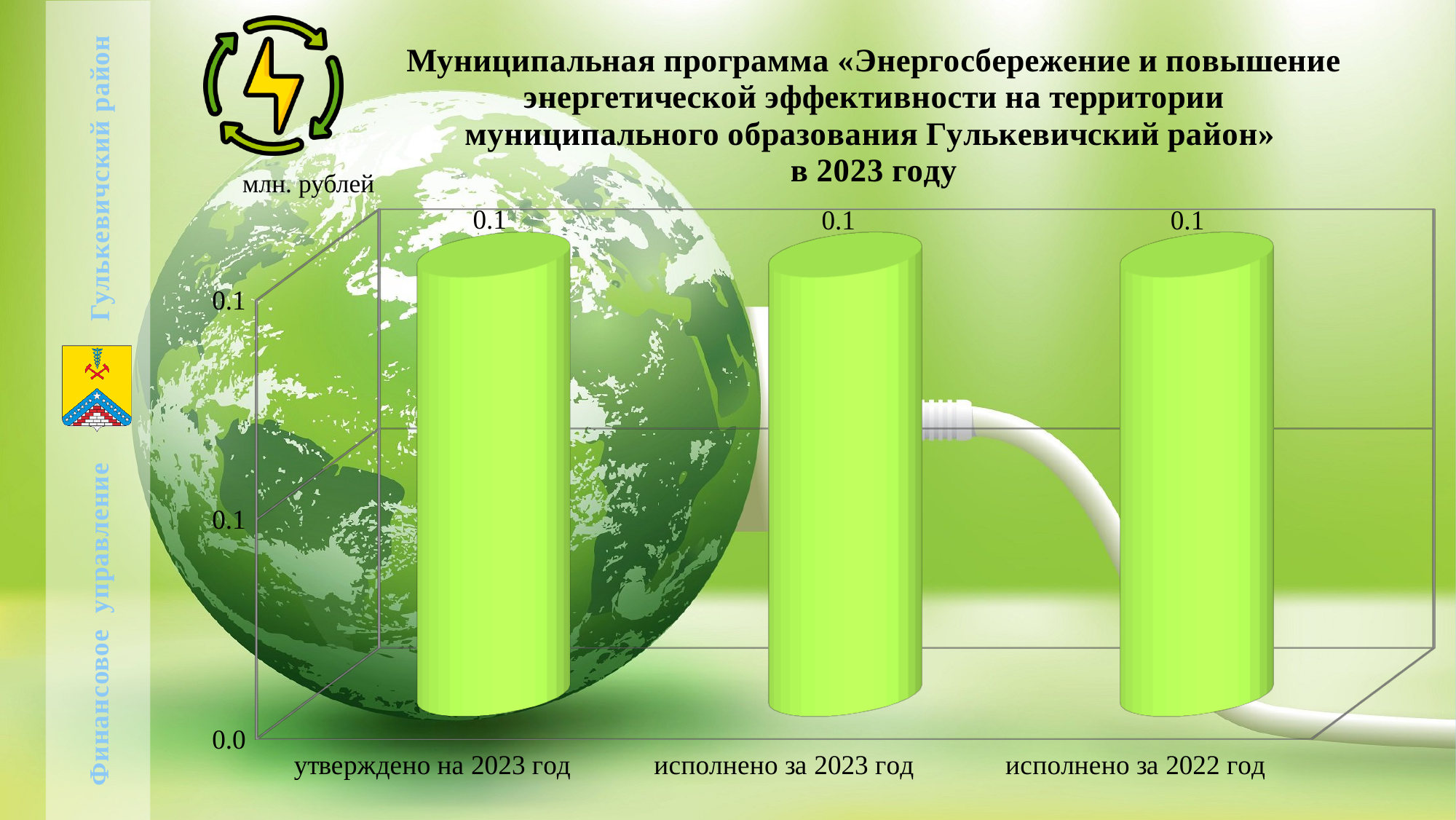
Which year does the title of the slide say the programme data refers to? 2023 In what units are the values on the chart expressed? млн. рублей What is the label of the last (rightmost) category on the x axis? исполнено за 2022 год What is the label of the first (leftmost) category on the x axis? утверждено на 2023 год Do the values rise, fall or stay the same across the three categories? stay the same What is the value for «утверждено на 2023 год»? 0.1 What kind of chart is shown on the slide? bar chart What is the value for «исполнено за 2022 год»? 0.1 How many categories are plotted on the chart? 3 What is the value for «исполнено за 2023 год»? 0.1